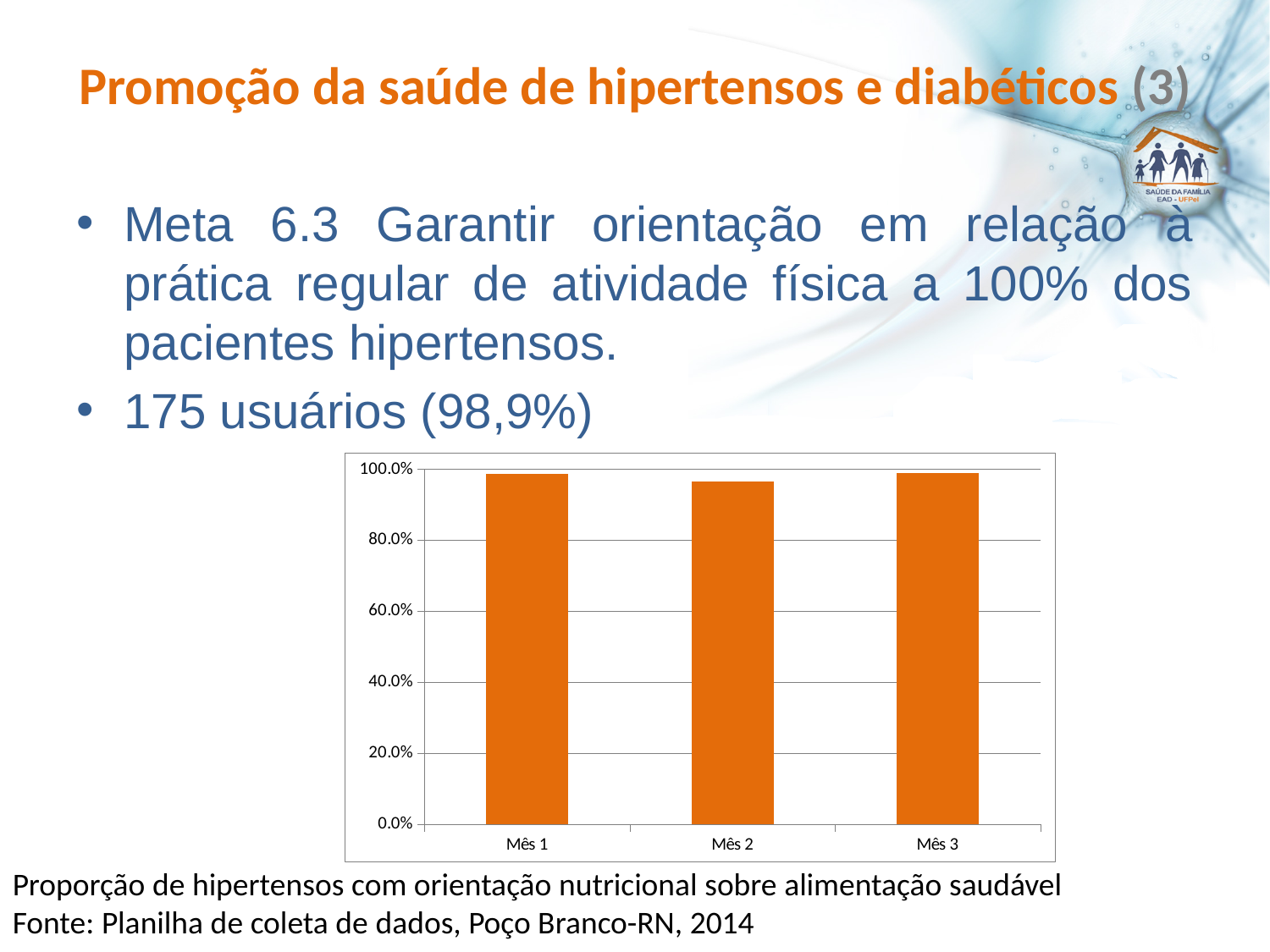
Is the value for Mês 3 greater or less than 60.0%? greater Is the value for Mês 1 greater or less than 80.0%? greater What kind of chart is shown on the slide? bar chart What colour are the bars in the chart? orange What is the highest tick value shown on the y axis of the chart? 100.0% Which is larger, the value for Mês 2 or the value for Mês 3? Mês 3 Is the value for Mês 2 greater or less than 100.0%? less How many categories (months) are shown on the x axis of the chart? 3 Which month has the lowest bar in the chart? Mês 2 Which is larger, the value for Mês 1 or the value for Mês 2? Mês 1